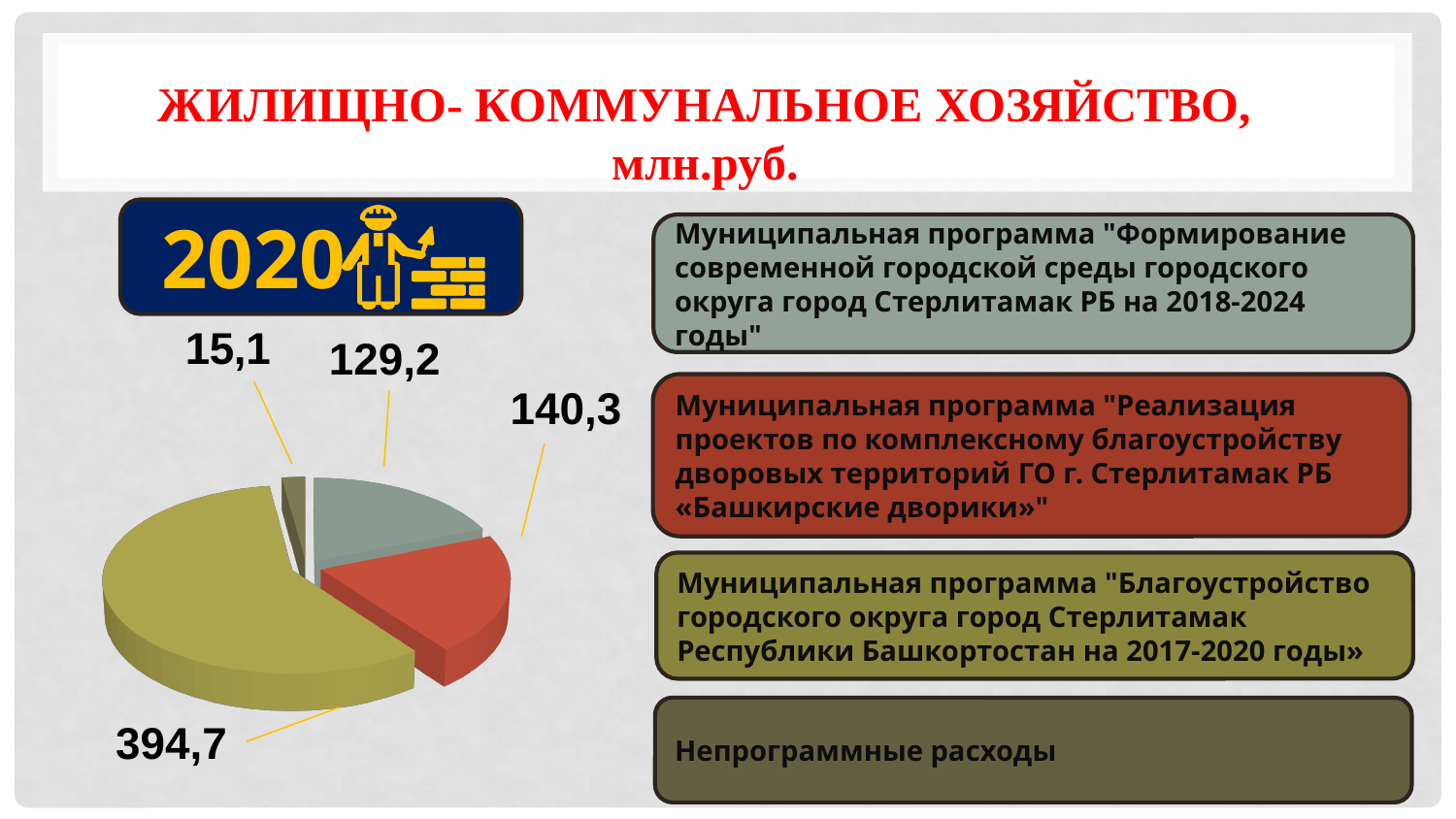
What kind of chart is shown on the slide? pie chart What is the value of the grey-green slice, corresponding to the programme "Формирование современной городской среды городского округа город Стерлитамак РБ на 2018-2024 годы"? 129,2 What is the difference between the slice labelled 140,3 and the slice labelled 129,2? 11,1 What is the value of the smallest slice of the pie chart? 15,1 What is the value of the slice for Непрограммные расходы? 15,1 Which year is shown in the blue box above the pie chart? 2020 What is the total of all four slices of the pie chart? 679,3 What is the value of the largest slice of the pie chart? 394,7 How many slices does the pie chart have? 4 What is the difference between the largest slice (394,7) and the smallest slice (15,1)? 379,6 What is the value of the red slice, corresponding to the programme «Башкирские дворики»? 140,3 Which is larger: the red slice (140,3) or the grey-green slice (129,2)? the red slice (140,3)